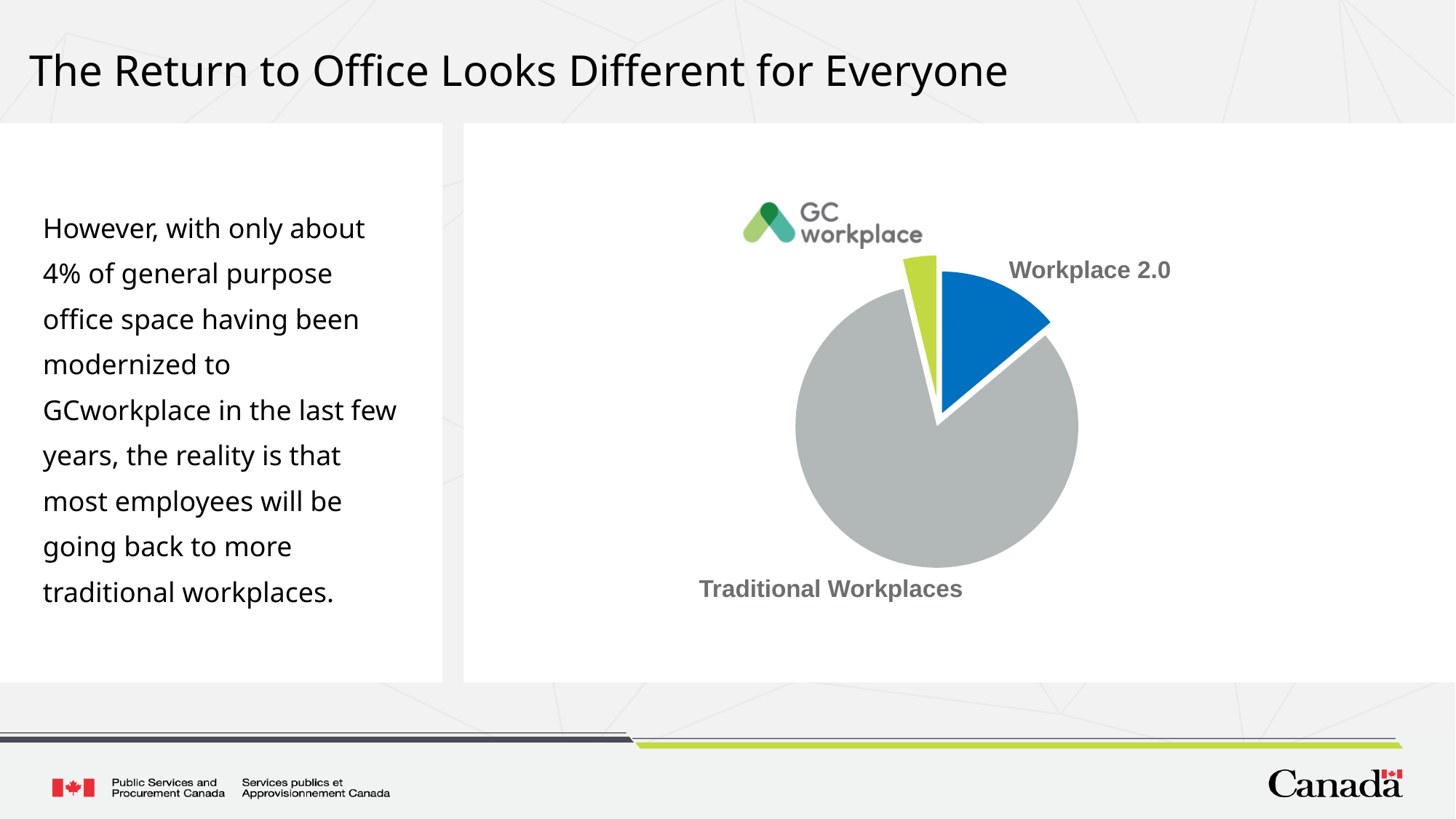
Which slice is larger, Workplace 2.0 or GCworkplace? Workplace 2.0 How many slices does the pie chart have? 3 Which slice is larger, Workplace 2.0 or Traditional Workplaces? Traditional Workplaces What colour is the Traditional Workplaces slice? grey Which slice of the pie chart is the largest? Traditional Workplaces What kind of chart is shown on the slide? pie chart What colour is the Workplace 2.0 slice? blue Which slice of the pie chart is the smallest? GCworkplace